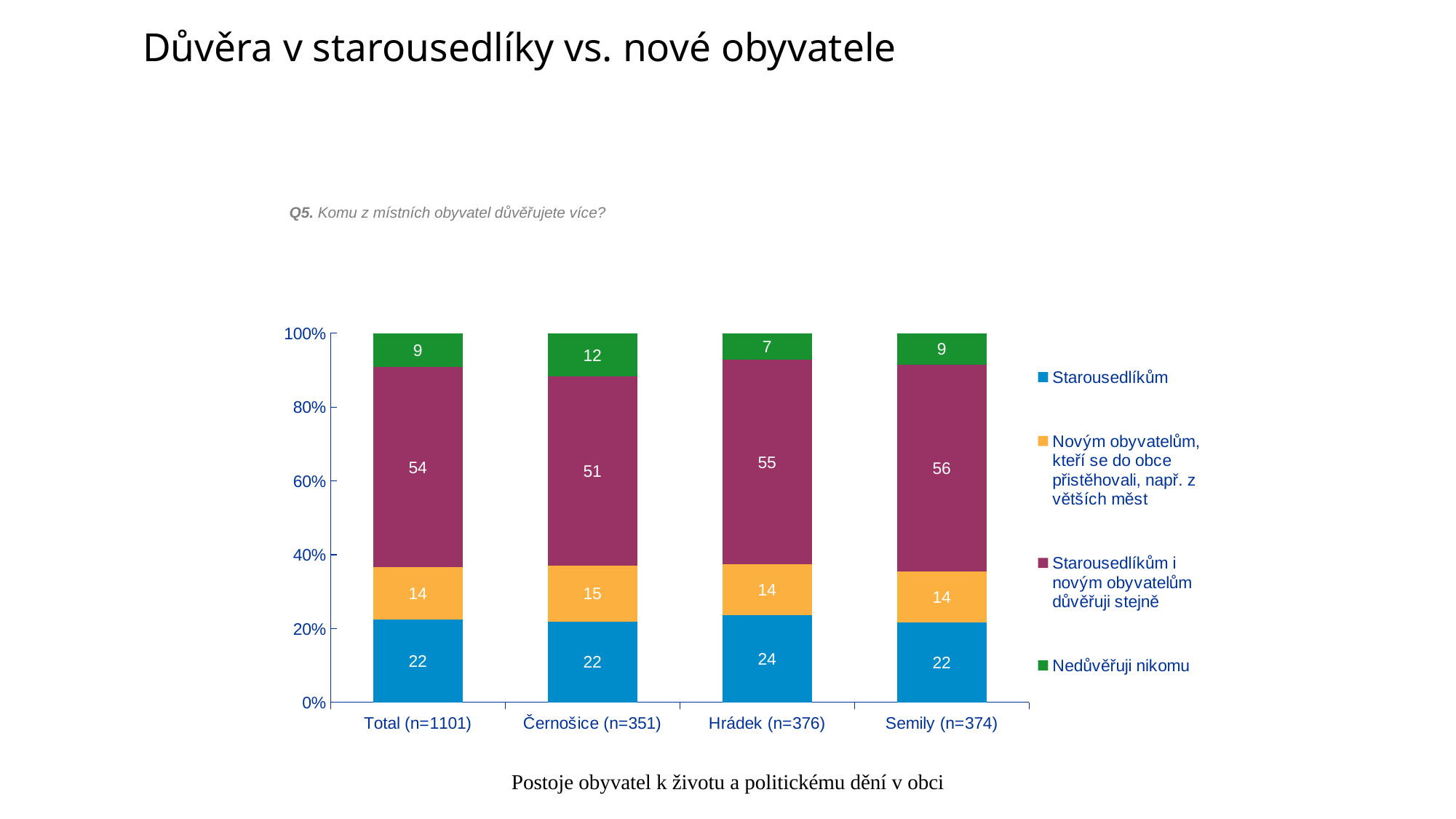
Which category has the lowest value for 'Starousedlíkům i novým obyvatelům důvěřuji stejně'? Černošice (n=351) What is the difference between the 'Nedůvěřuji nikomu' values for Černošice (n=351) and Hrádek (n=376)? 5 Which category has the highest value for 'Nedůvěřuji nikomu'? Černošice (n=351) What is the value for 'Nedůvěřuji nikomu' in the Černošice (n=351) bar? 12 How many categories (groups of respondents) are shown on the x axis? 4 Which is larger: the 'Starousedlíkům' value for Hrádek (n=376) or for Semily (n=374)? Hrádek (n=376) What kind of chart is shown on the slide? Stacked bar chart What is the value for 'Starousedlíkům i novým obyvatelům důvěřuji stejně' in the Total (n=1101) bar? 54 What colour represents 'Nedůvěřuji nikomu' in the legend? Green How many series does the legend list? 4 What is the value for 'Starousedlíkům' in the Hrádek (n=376) bar? 24 What is the sum of the four labelled segments in the Hrádek (n=376) bar? 100